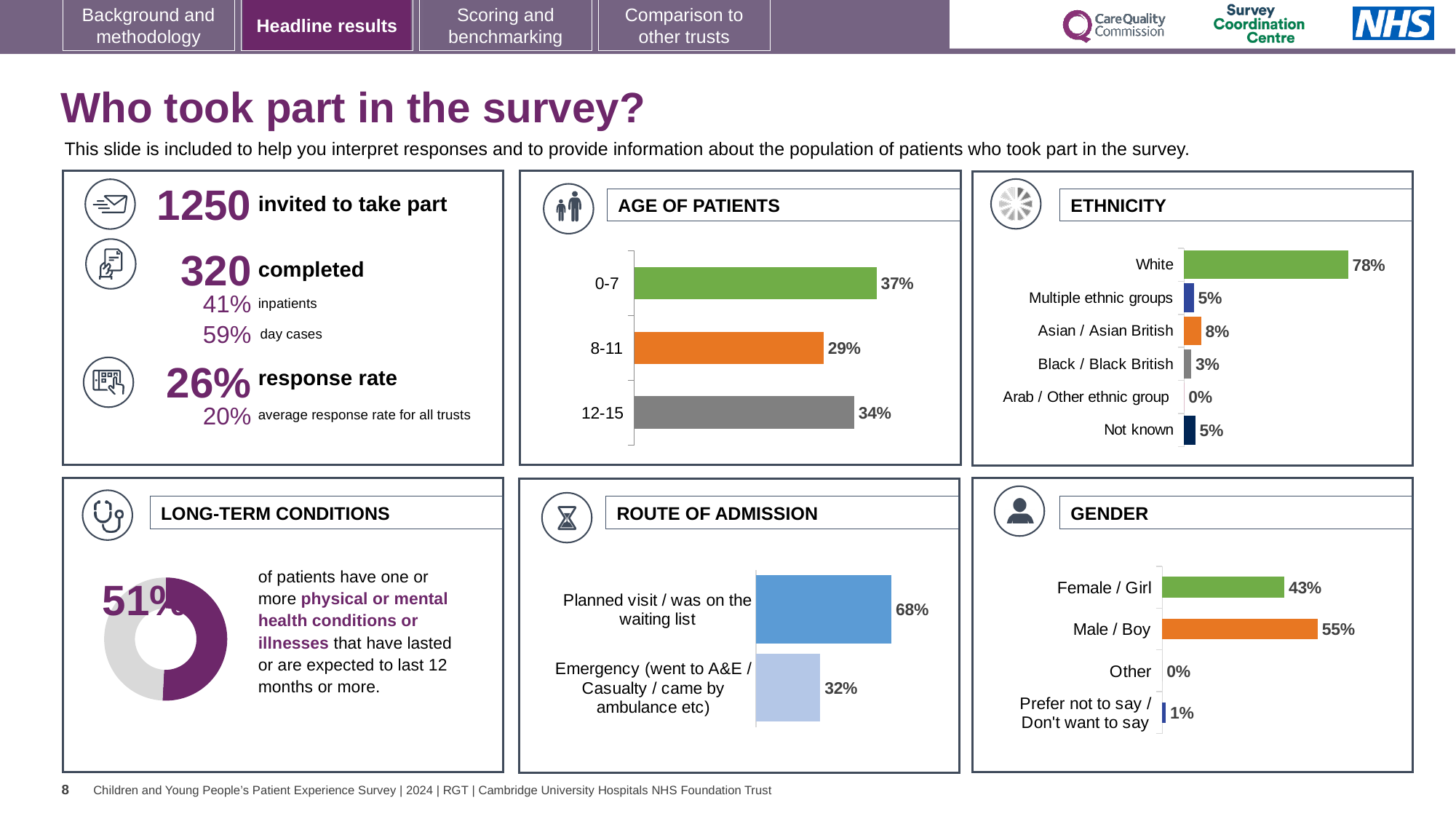
In the LONG-TERM CONDITIONS chart, what share of patients have one or more long-term conditions? 51% In the ROUTE OF ADMISSION chart, what percentage of patients came via Emergency (went to A&E / Casualty / came by ambulance etc)? 32% What kind of chart is the LONG-TERM CONDITIONS chart? Doughnut chart In the AGE OF PATIENTS chart, what is the difference between the 0-7 and 12-15 percentages? 3% In the GENDER chart, which is larger, Female / Girl or Male / Boy? Male / Boy In the GENDER chart, what percentage of patients were Prefer not to say / Don't want to say? 1% In the AGE OF PATIENTS chart, what percentage of patients were aged 0-7? 37% In the ROUTE OF ADMISSION chart, what is the difference between the Planned visit and Emergency percentages? 36% In the ETHNICITY chart, which category has the highest percentage? White In the ETHNICITY chart, what percentage of patients were Asian / Asian British? 8% In the AGE OF PATIENTS chart, which age group has the lowest percentage? 8-11 How many categories are shown in the ETHNICITY chart? 6